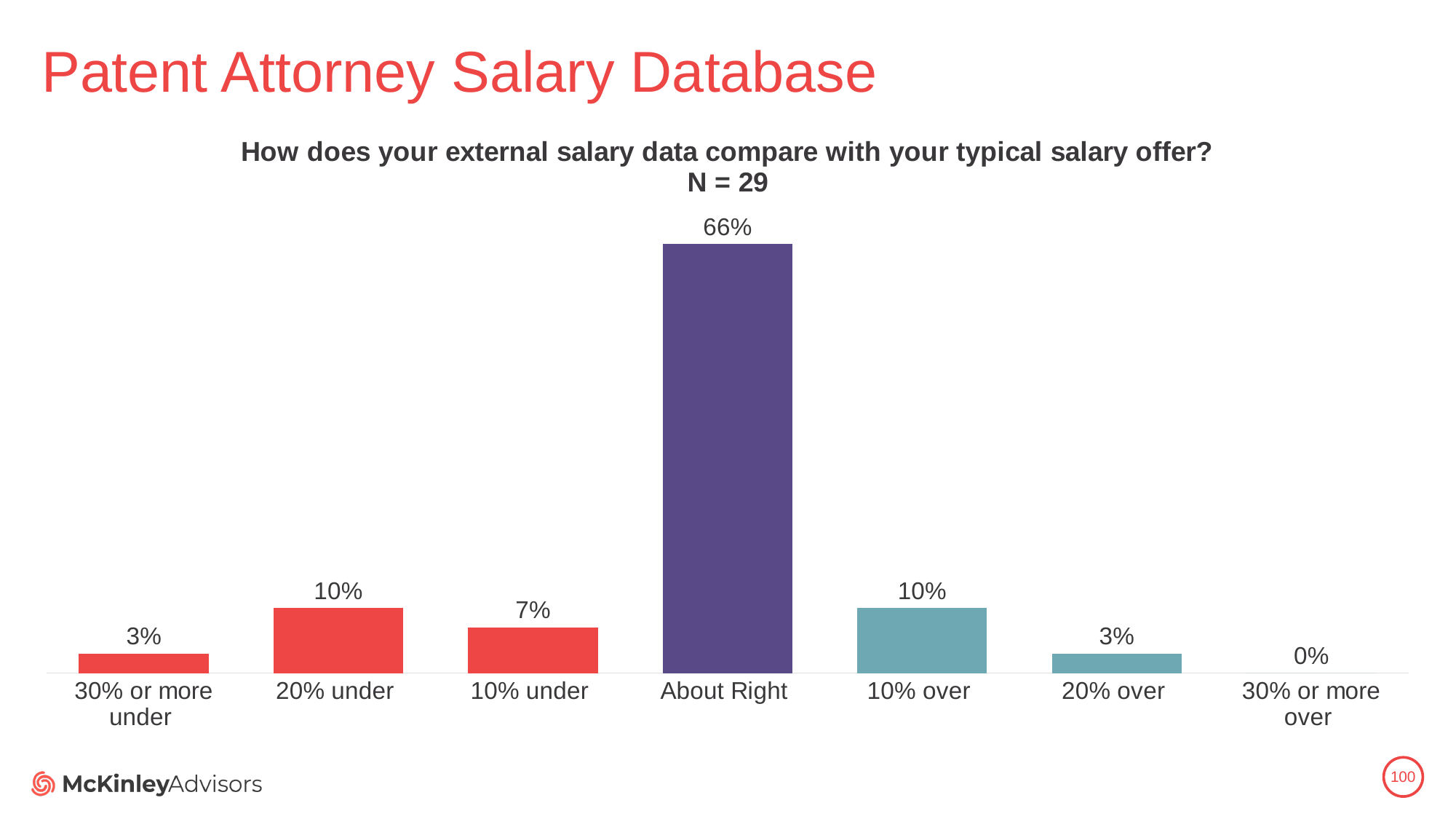
What is the value shown for '20% under'? 10% What percentage of respondents said their external salary data is 'About Right' compared with their typical salary offer? 66% Which category has the lowest value? 30% or more over What is the difference between the 'About Right' value and the '10% over' value? 56% What is the value shown for '30% or more over'? 0% What is the sample size (N) stated in the chart title? 29 What is the value shown for '10% under'? 7% Which is larger, the value for '20% under' or the value for '10% under'? 20% under How many categories are shown on the x axis? 7 Which category has the highest value? About Right What colour is the 'About Right' bar? Purple What kind of chart is shown on the slide? Bar chart